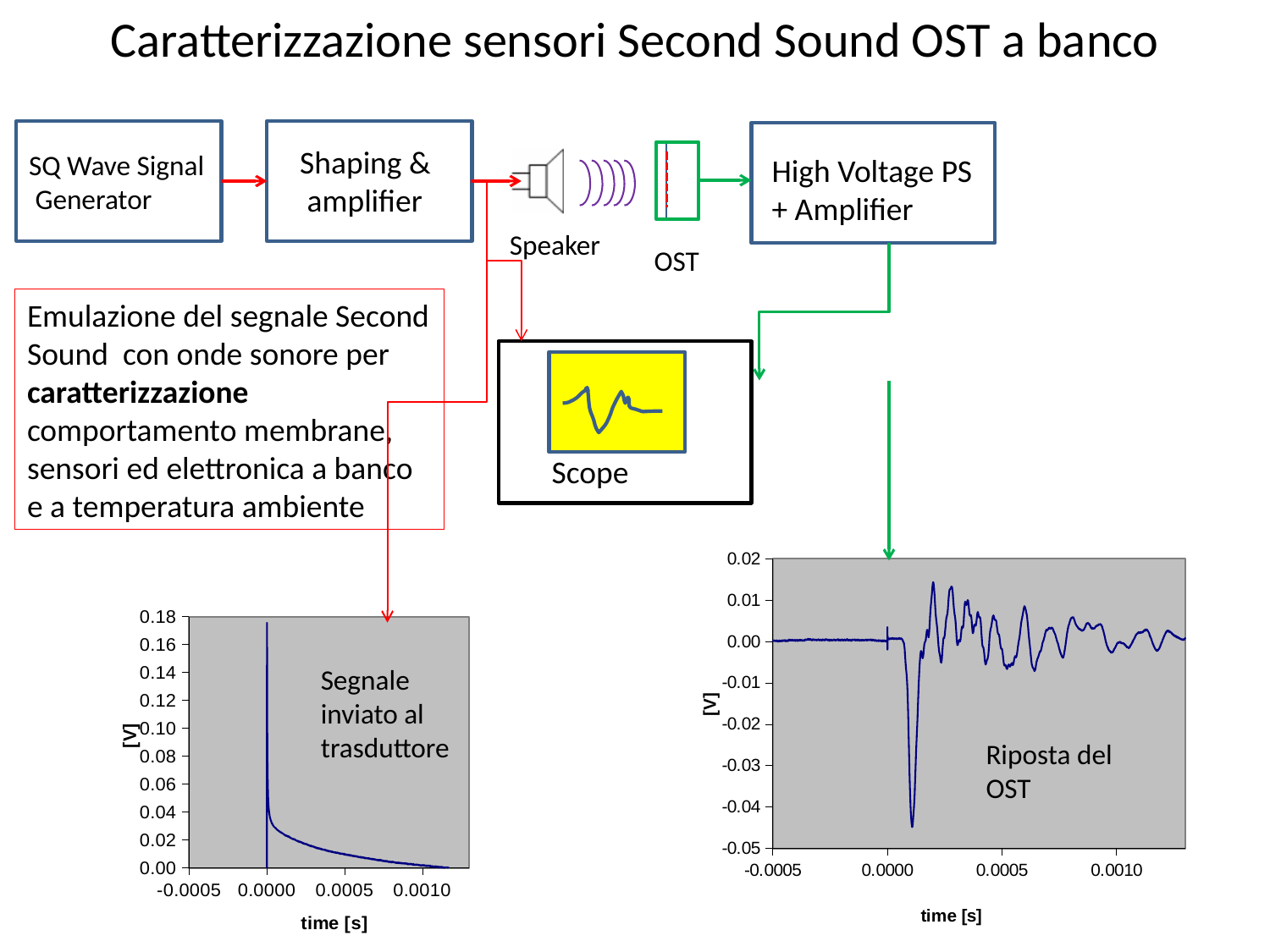
In the 'Riposta del OST' chart, is the lowest value of the signal greater or less than -0.03? less In the 'Riposta del OST' chart, is the highest value of the signal greater or less than 0.01? greater In the 'Segnale inviato al trasduttore' chart, after the spike at 0.0000 s, do the values rise or fall as time increases? fall In the 'Segnale inviato al trasduttore' chart, is the peak value of the signal greater or less than 0.14? greater In the 'Segnale inviato al trasduttore' chart, what is the highest value shown on the y axis? 0.18 In the 'Riposta del OST' chart, what is the highest value shown on the y axis? 0.02 In the 'Riposta del OST' chart, what is the label of the y axis? [V] What kind of chart is the 'Riposta del OST' chart at the bottom right? line chart What kind of chart is the 'Segnale inviato al trasduttore' chart at the bottom left? line chart How many lines are plotted in the 'Riposta del OST' chart? 1